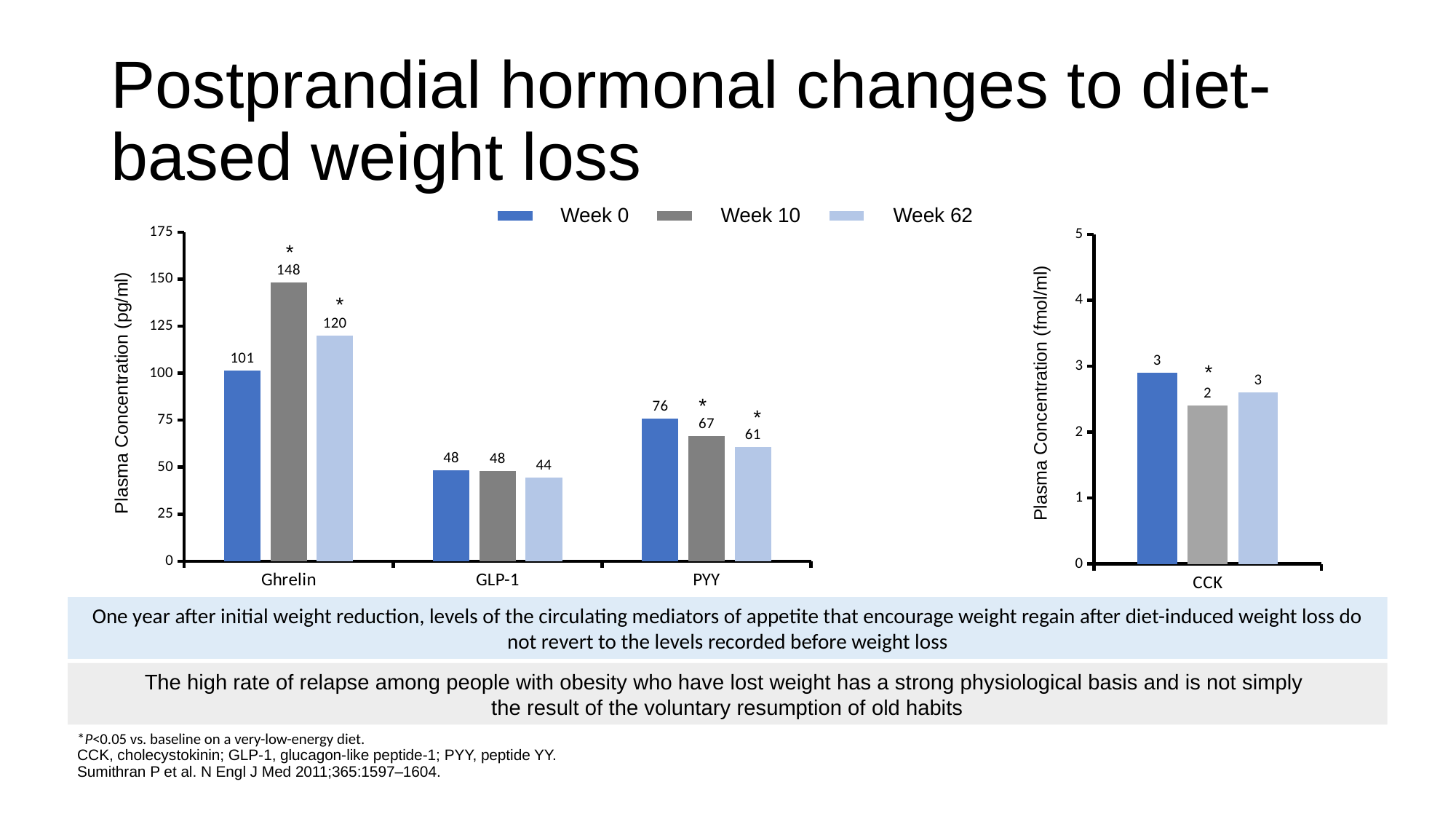
In the left chart, what is the Week 0 value for GLP-1? 48 In the left chart, what is the Week 62 plasma concentration for PYY? 61 In the right chart, what is the Week 10 plasma concentration for CCK? 2 In the left chart, is the Week 62 value for Ghrelin larger or smaller than the Week 0 value for Ghrelin? larger In the left chart, what is the difference between the Week 10 and Week 0 values for Ghrelin? 47 In the left chart, which hormone has the lowest Week 62 value? GLP-1 How many series does the legend list? 3 In the left chart, what is the difference between the Week 0 and Week 62 values for PYY? 15 What kind of chart is the right chart showing CCK? bar chart In the left chart, is the Week 0 value for PYY greater or less than 75? greater In the left chart, which hormone has the highest Week 0 value? Ghrelin In the left chart, what is the Week 10 plasma concentration for Ghrelin? 148